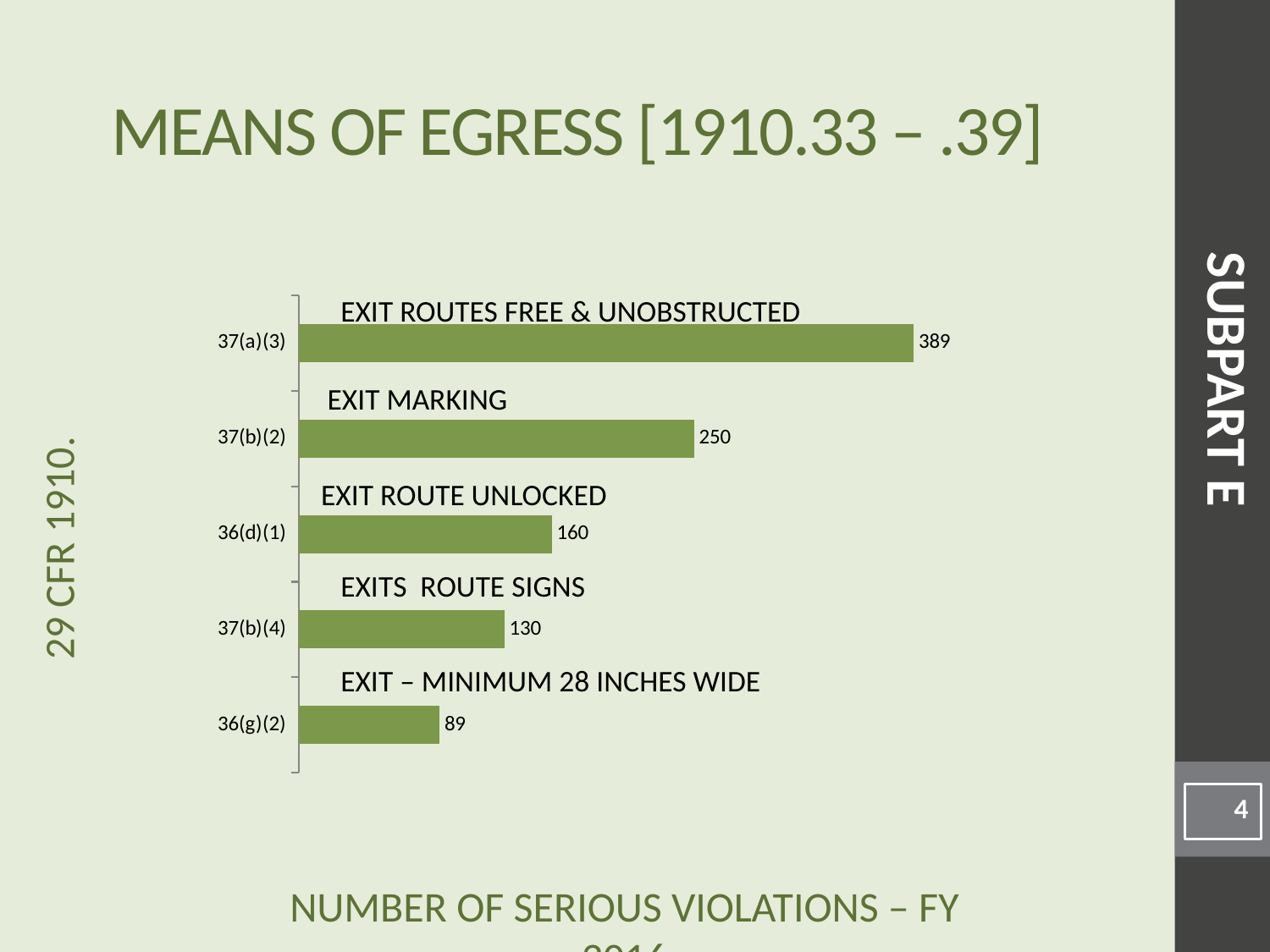
Which category has the highest value? 37(a)(3) What is the difference between the values for 37(a)(3) and 37(b)(2)? 139 What is the value for 36(d)(1)? 160 What is the value for 37(a)(3)? 389 What is the value for 36(g)(2)? 89 What label is shown above the bar for 37(b)(2)? EXIT MARKING Which category has the lowest value? 36(g)(2) Which is larger, the value for 37(b)(4) or the value for 36(g)(2)? 37(b)(4) What is the difference between the values for 36(d)(1) and 37(b)(4)? 30 What kind of chart is shown on the slide? bar chart How many categories are shown in the chart? 5 What is the value for 37(b)(2)? 250